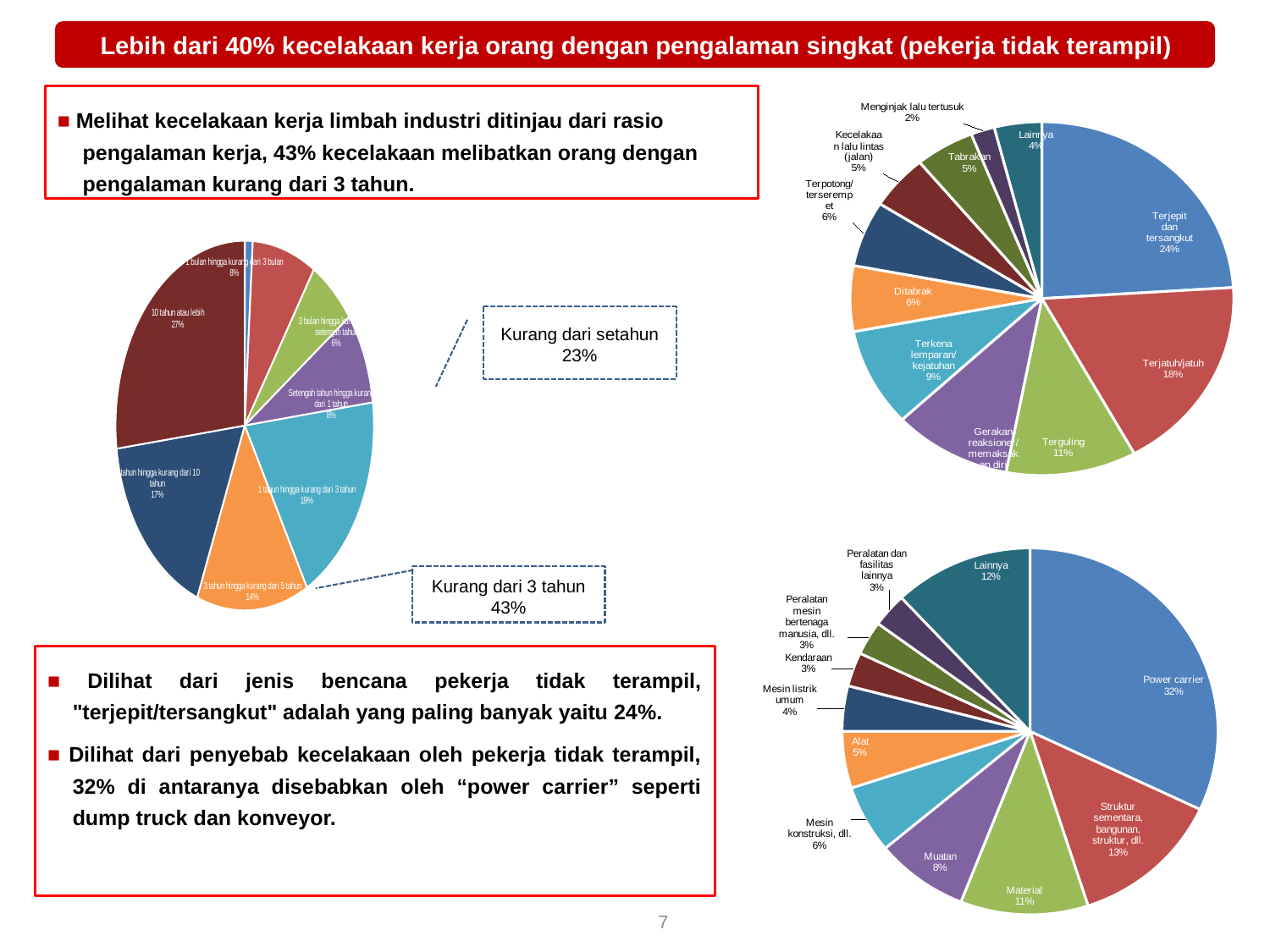
In the left pie chart, what share is labelled for "1 tahun hingga kurang dari 3 tahun"? 19% According to the callout on the left pie chart, what share of accidents involved workers with less than 3 years of experience ("Kurang dari 3 tahun")? 43% In the left pie chart, what share is labelled for "10 tahun atau lebih"? 27% How many categories are shown in the bottom-right pie chart? 11 In the top-right pie chart, what share is labelled for "Terjepit dan tersangkut"? 24% In the top-right pie chart, which category has the smallest labelled share? Menginjak lalu tertusuk In the top-right pie chart, what is the difference between the shares for "Terjatuh/jatuh" and "Terguling"? 7% In the bottom-right pie chart, what share is labelled for "Power carrier"? 32% In the bottom-right pie chart, what share is labelled for "Lainnya"? 12% In the bottom-right pie chart, which is larger: "Material" or "Muatan"? Material What type of chart is the top-right chart? Pie chart In the top-right pie chart, which category has the largest slice? Terjepit dan tersangkut